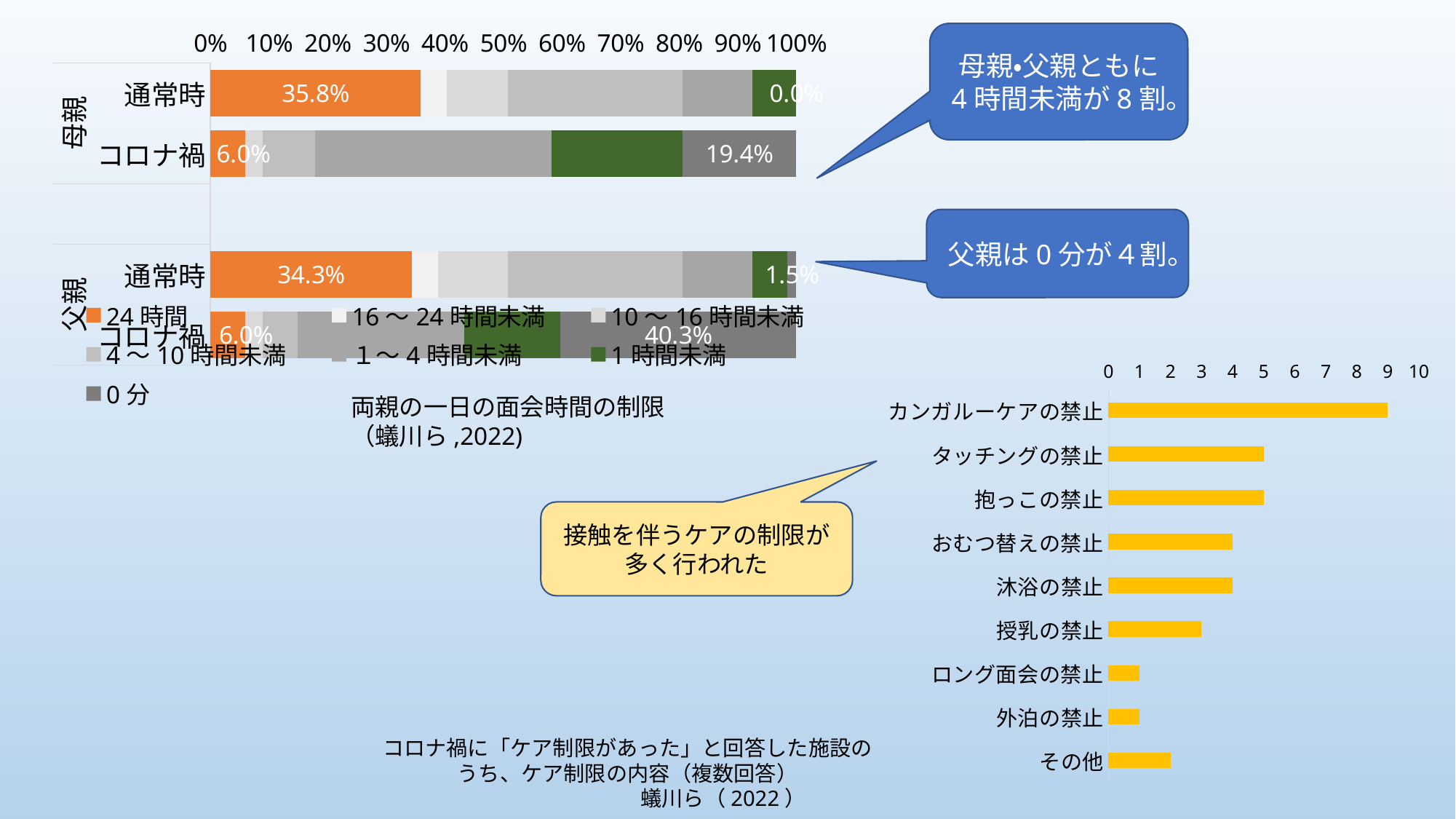
In the chart titled 両親の一日の面会時間の制限, how many series does the legend list? 7 In the bar chart at the bottom right about ケア制限の内容, is the value for 授乳の禁止 greater or less than 5? less In the chart titled 両親の一日の面会時間の制限, which is larger: the 24時間 value for 母親 通常時 or for 母親 コロナ禍? 母親 通常時 In the chart titled 両親の一日の面会時間の制限, what is the value of the 0分 segment for 父親 コロナ禍? 40.3% In the chart titled 両親の一日の面会時間の制限, what is the difference between the 0分 values for 父親 コロナ禍 and 母親 コロナ禍? 20.9% In the chart titled 両親の一日の面会時間の制限, what is the value of the 24時間 segment for 母親 通常時? 35.8% In the chart titled 両親の一日の面会時間の制限, what is the value of the 24時間 segment for 父親 通常時? 34.3% In the bar chart at the bottom right about ケア制限の内容, what is the value for カンガルーケアの禁止? 9 In the chart titled 両親の一日の面会時間の制限, what is the value of the 0分 segment for 母親 コロナ禍? 19.4% In the bar chart at the bottom right about ケア制限の内容, which category has the highest value? カンガルーケアの禁止 In the bar chart at the bottom right about ケア制限の内容, how many categories are shown? 9 What kind of chart is the one at the bottom right about ケア制限の内容? bar chart